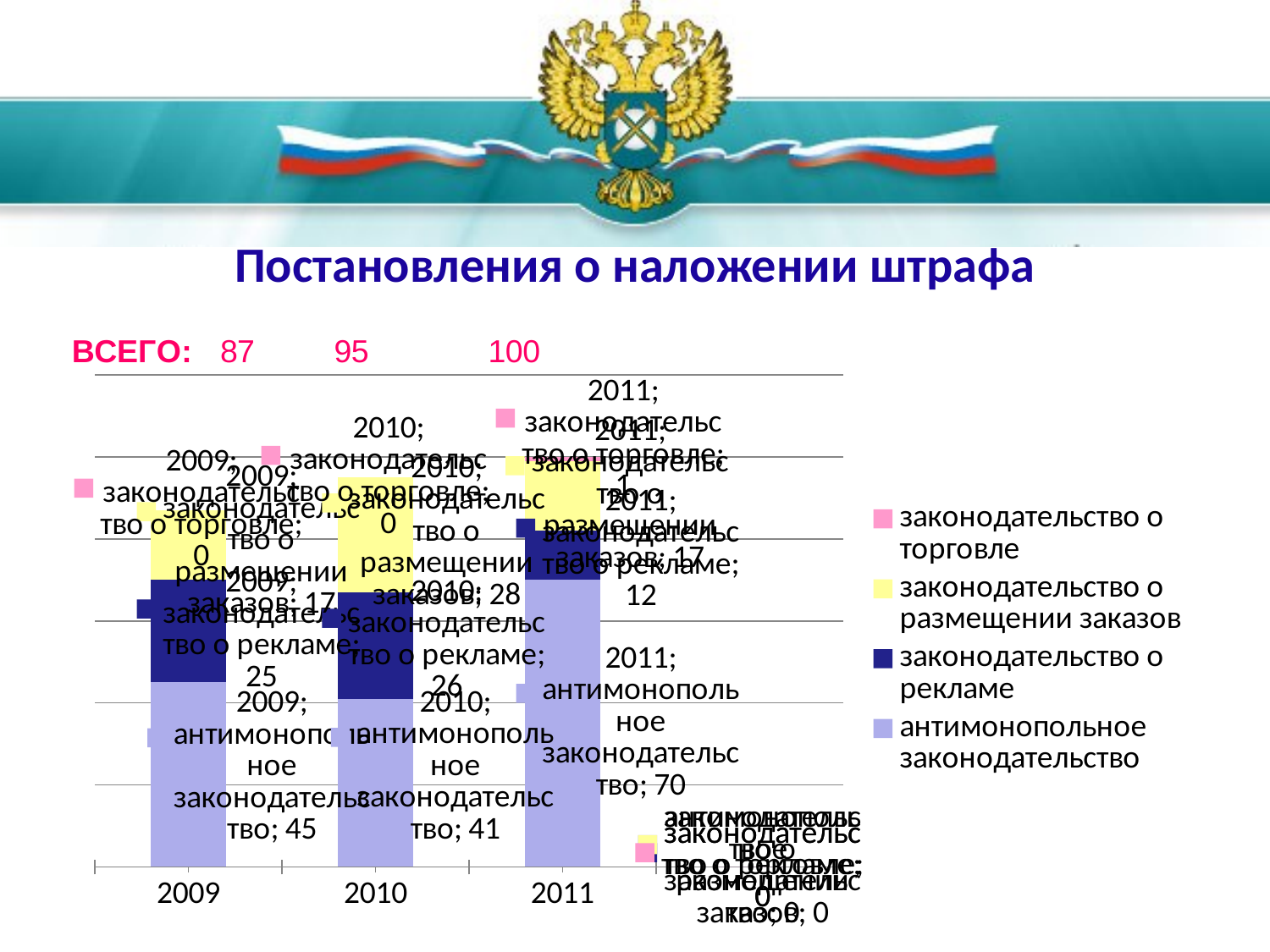
What is the total (ВСЕГО) for 2010? 95 Which year has the highest value for антимонопольное законодательство? 2011 What type of chart is shown on the slide? stacked bar chart Which is larger: законодательство о размещении заказов in 2010 or in 2011? 2010 What is the difference between антимонопольное законодательство in 2011 and in 2009? 25 What is the value for законодательство о рекламе in 2010? 26 What is the value for законодательство о торговле in 2011? 1 What is the value for антимонопольное законодательство in 2011? 70 What is the title of the chart on the slide? Постановления о наложении штрафа How many years (categories) are shown on the x axis? 3 How many series does the legend list? 4 What is the value for законодательство о размещении заказов in 2009? 17